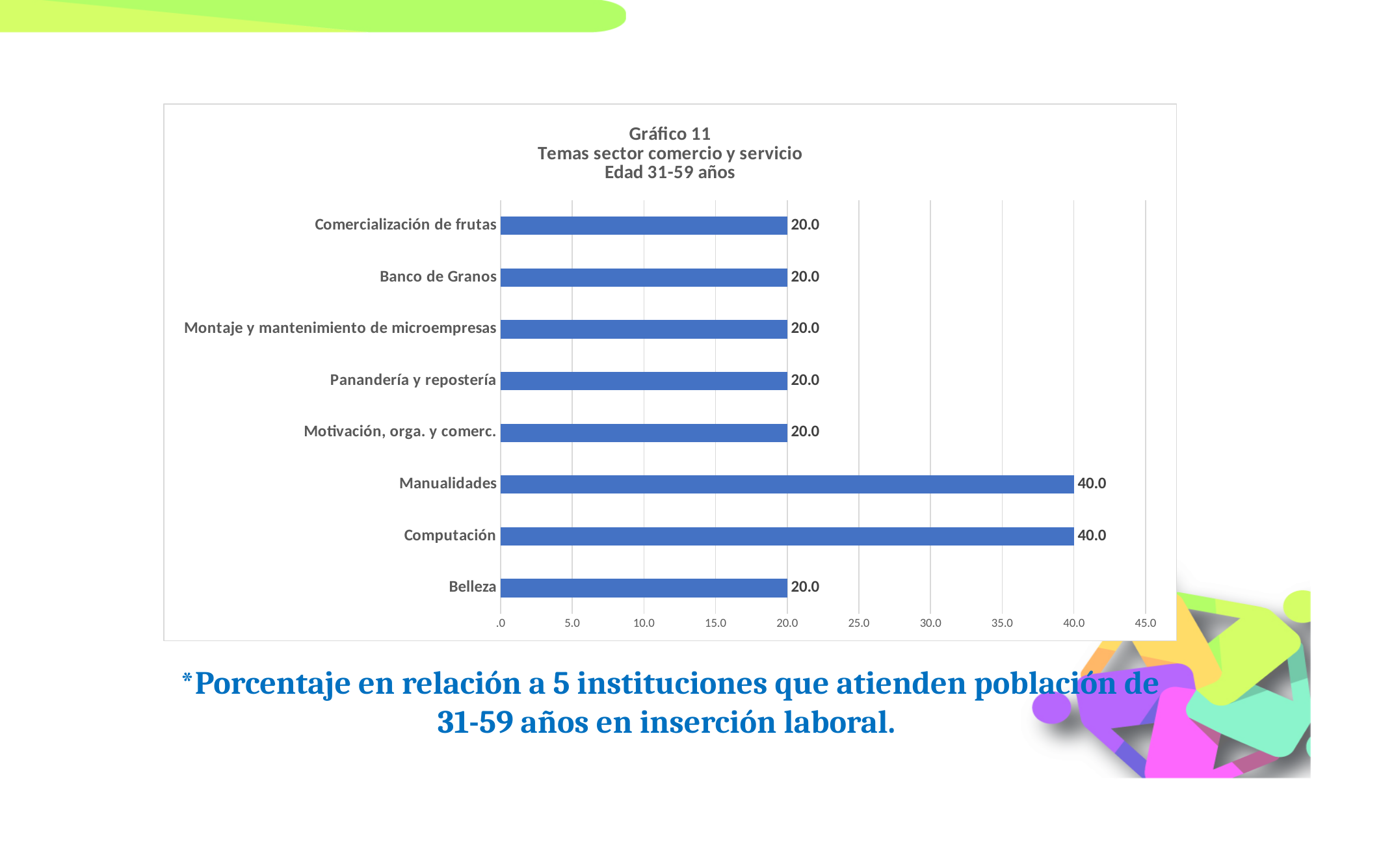
What is the difference between the values for Computación and Belleza? 20.0 What is the value for Banco de Granos? 20.0 What is the value for Computación? 40.0 Is the value for Comercialización de frutas greater or less than 30.0? less What is the value for Manualidades? 40.0 Which categories have the highest value? Manualidades and Computación What kind of chart is shown on the slide? bar chart How many categories have a value of 20.0? 6 Which is larger, the value for Manualidades or the value for Panandería y repostería? Manualidades What is the title of the chart? Gráfico 11 Temas sector comercio y servicio Edad 31-59 años What is the value for Belleza? 20.0 How many categories are shown in the chart? 8